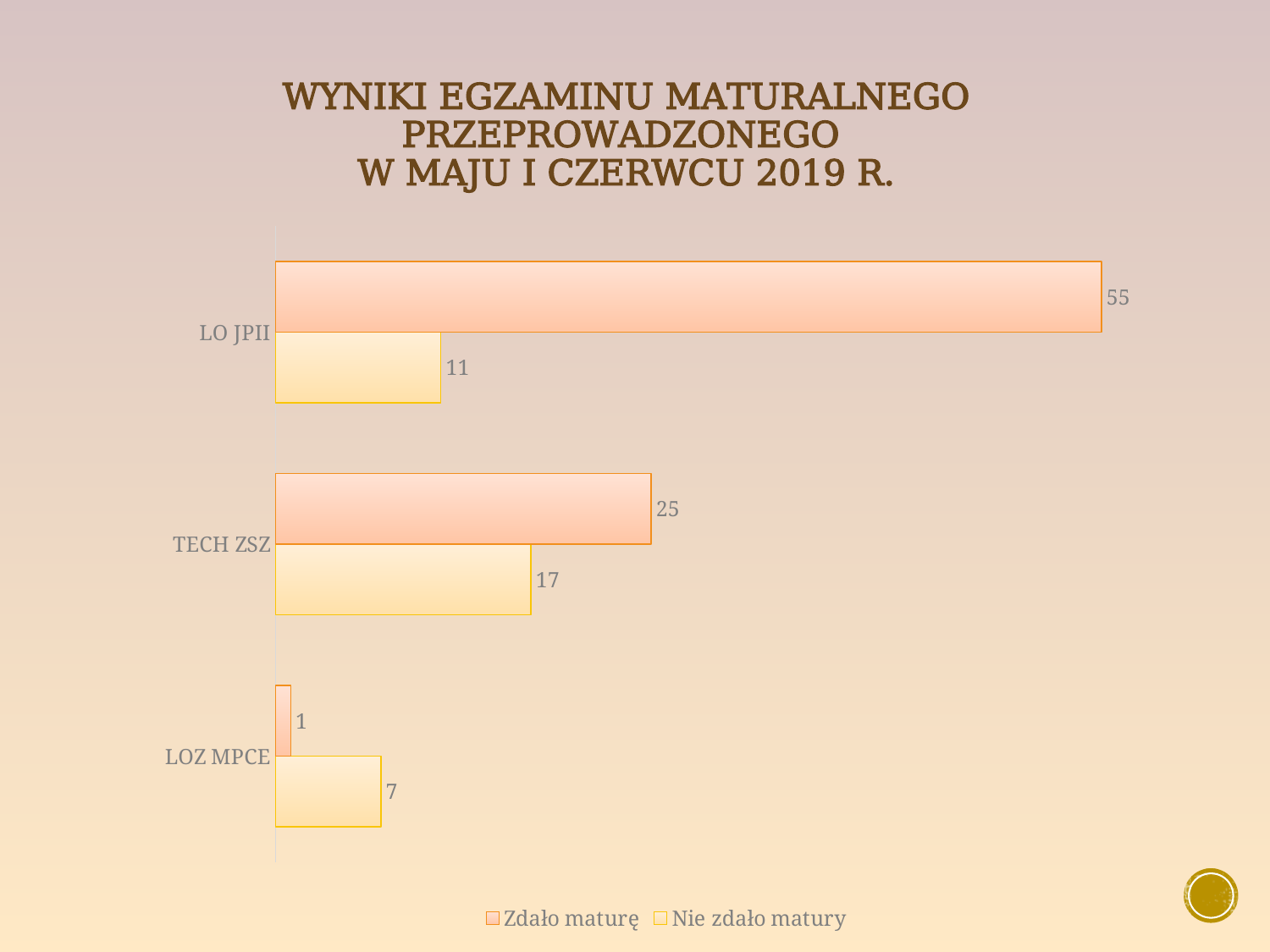
How many schools (categories) are shown in the chart? 3 How many series does the legend list? 2 What is the value for Nie zdało matury at LOZ MPCE? 7 How many students did not pass the matura exam (Nie zdało matury) at TECH ZSZ? 17 What is the value for Zdało maturę at LOZ MPCE? 1 Which school has the highest number of students who passed the matura (Zdało maturę)? LO JPII What is the difference between the number of students who passed and those who did not pass at LO JPII? 44 At LOZ MPCE, which is larger: Zdało maturę or Nie zdało matury? Nie zdało matury What is the difference between Zdało maturę and Nie zdało matury at TECH ZSZ? 8 Which school has the lowest number of students who did not pass the matura (Nie zdało matury)? LOZ MPCE How many students passed the matura exam (Zdało maturę) at LO JPII? 55 What kind of chart is shown on the slide? Bar chart